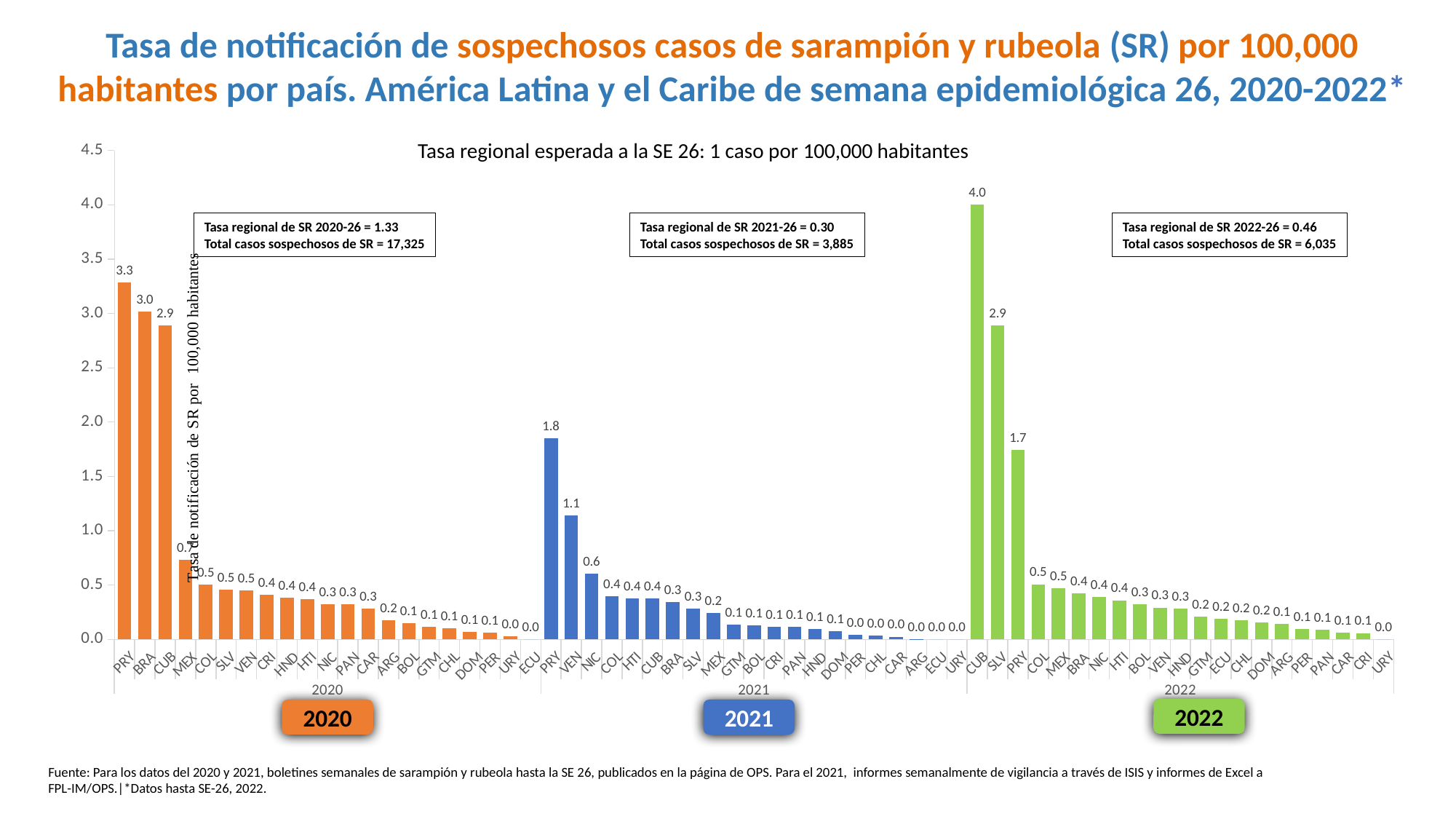
What is the difference between the PRY rate in 2020 and the PRY rate in 2021? 1.5 What is the notification rate for CUB in 2022? 4.0 Is the value for VEN in 2021 greater or less than 1.0? greater Within the 2020 group, do the values rise or fall from left to right? fall What kind of chart is shown on the slide? bar chart What is the notification rate for PRY in 2020? 3.3 What is the notification rate for NIC in 2021? 0.6 According to the text box, what is the regional SR rate for 2020-26? 1.33 Which country has the highest notification rate in the 2022 group? CUB Which is larger: the BRA rate in 2020 or the SLV rate in 2022? BRA in 2020 Which country has the highest notification rate in the 2020 group? PRY How many countries are plotted in the 2021 group? 21